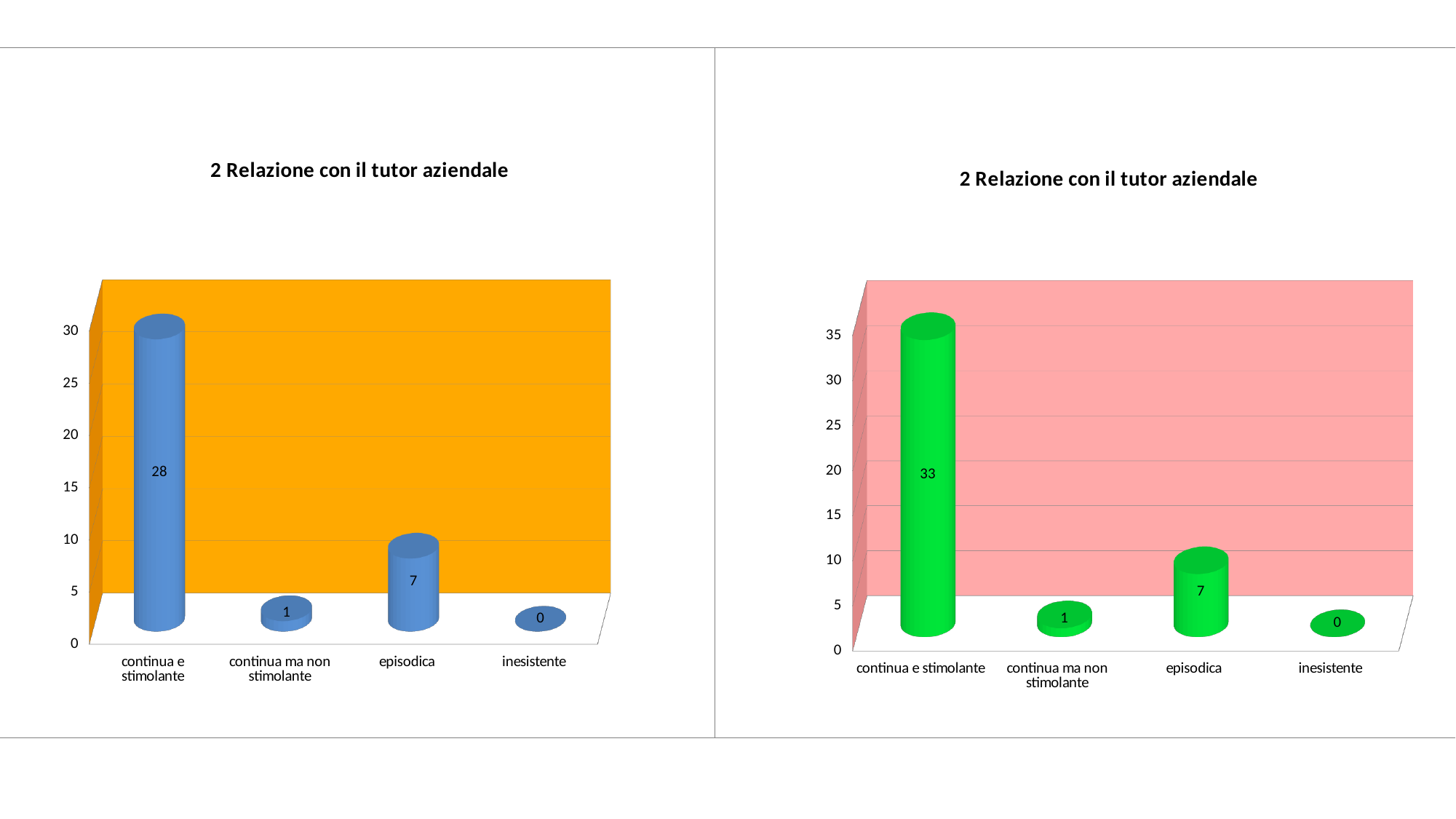
What is the title of the left chart? 2 Relazione con il tutor aziendale In the right chart, what is the value for 'continua e stimolante'? 33 In the left chart, what is the difference between 'continua e stimolante' and 'episodica'? 21 In the right chart, which category has the lowest value? inesistente In the left chart, which category has the highest value? continua e stimolante Which chart has the larger value for 'continua e stimolante', the left chart or the right chart? the right chart What kind of chart is the right chart? bar chart In the left chart, what is the value for 'episodica'? 7 In the right chart, what is the value for 'continua ma non stimolante'? 1 In the right chart, what is the difference between 'continua e stimolante' and 'episodica'? 26 How many categories are shown in the left chart? 4 In the left chart, what is the value for 'continua e stimolante'? 28